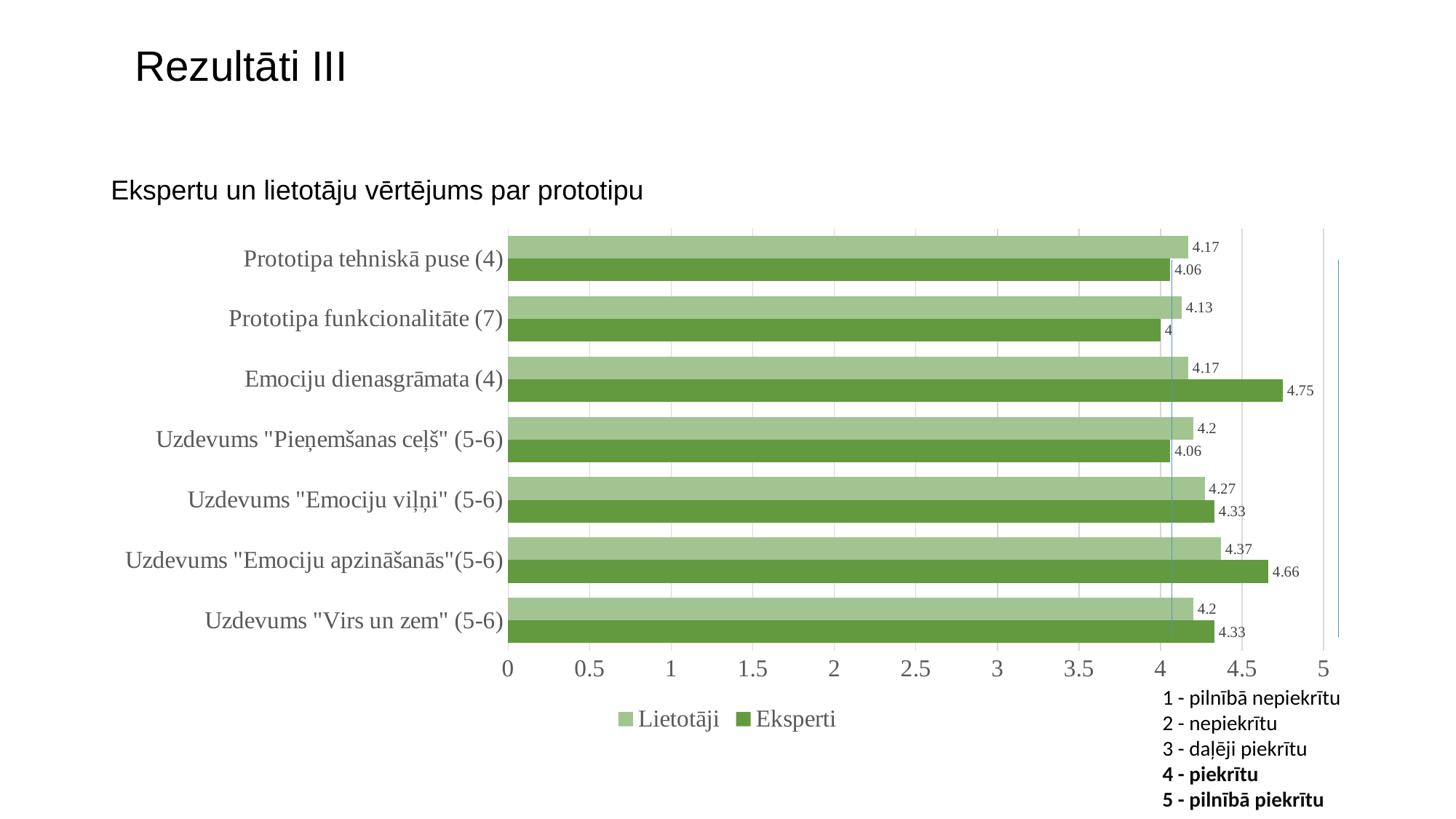
Which category has the highest Lietotāji value? Uzdevums "Emociju apzināšanās"(5-6) What kind of chart is shown on the slide? Bar chart Which category has the highest Eksperti value? Emociju dienasgrāmata (4) How many series does the legend list? 2 What is the Eksperti value for Emociju dienasgrāmata (4)? 4.75 What is the Eksperti value for Prototipa funkcionalitāte (7)? 4 What is the Lietotāji value for Prototipa tehniskā puse (4)? 4.17 For Uzdevums "Emociju apzināšanās"(5-6), which is larger: the Lietotāji value or the Eksperti value? Eksperti What is the difference between the Eksperti and Lietotāji values for Emociju dienasgrāmata (4)? 0.58 Which category has the lowest Eksperti value? Prototipa funkcionalitāte (7) How many categories are shown on the chart? 7 What is the Lietotāji value for Uzdevums "Emociju apzināšanās"(5-6)? 4.37